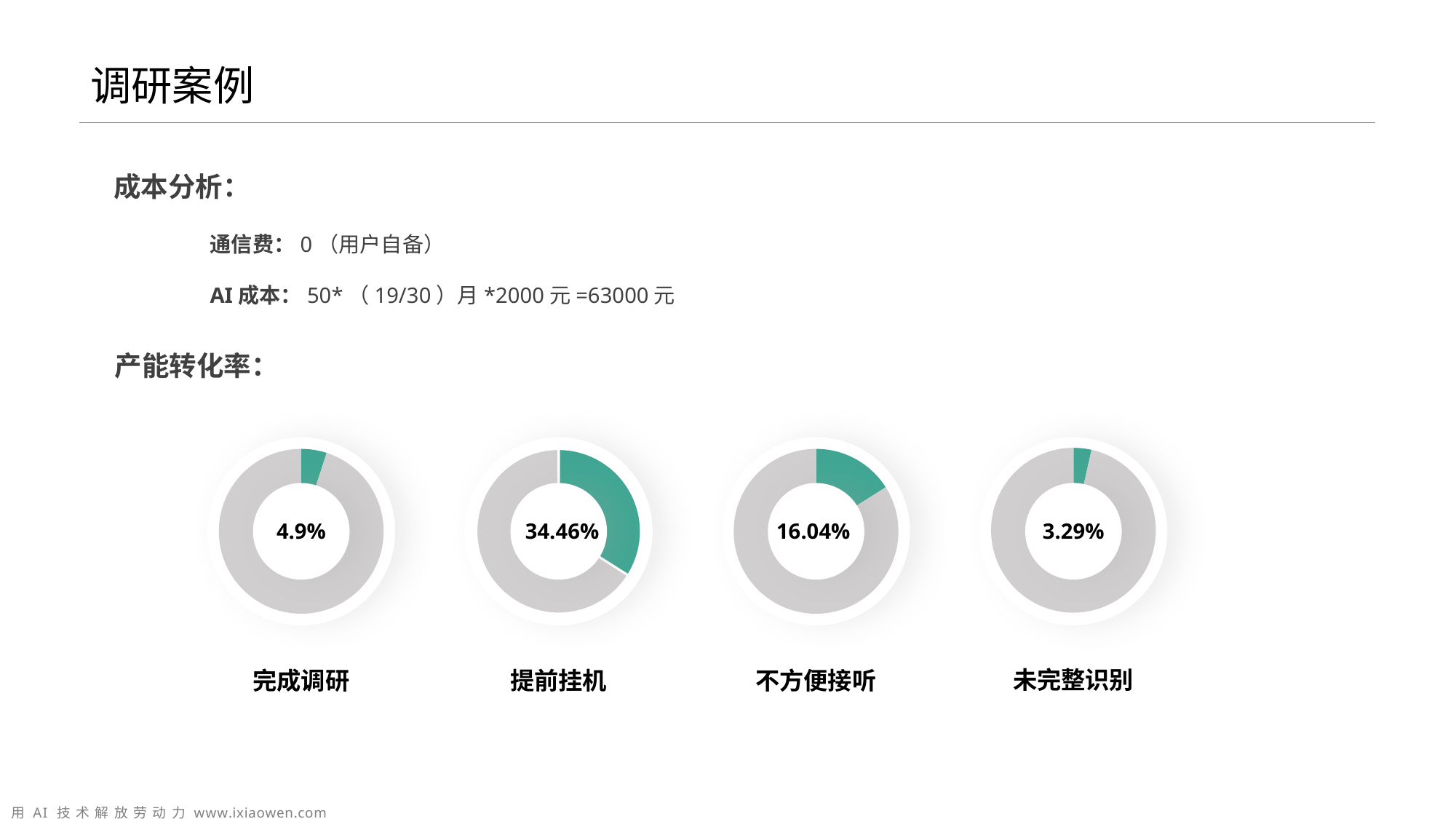
What is the difference between the percentages shown in the 完成调研 and 未完整识别 donut charts? 1.61% What percentage is shown in the 提前挂机 donut chart? 34.46% What percentage is shown in the 未完整识别 donut chart? 3.29% What is the difference between the percentages shown in the 提前挂机 and 不方便接听 donut charts? 18.42% Among the four donut charts under 产能转化率, which category has the lowest percentage? 未完整识别 What colour is used for the highlighted (filled) portion of each donut chart? Green What kind of chart is used to display the 产能转化率 values on the slide? Donut (pie) chart What percentage is shown in the 完成调研 donut chart? 4.9% Among the four donut charts under 产能转化率, which category has the highest percentage? 提前挂机 Which is larger, the percentage in the 不方便接听 donut chart or the percentage in the 完成调研 donut chart? 不方便接听 What percentage is shown in the 不方便接听 donut chart? 16.04% How many donut charts are shown under 产能转化率 on the slide? 4